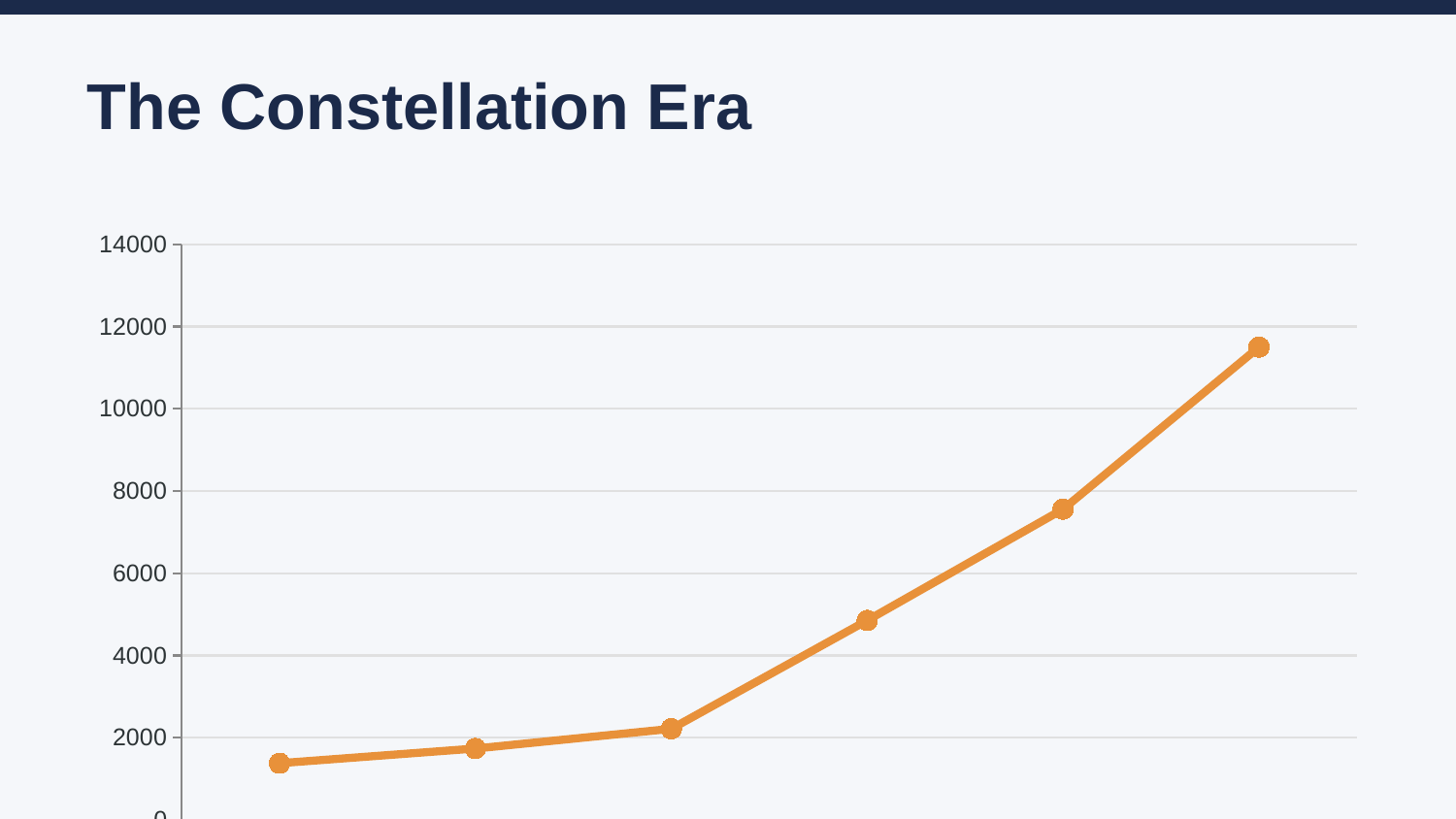
Is the value of the last (rightmost) data point greater or less than 12000? less Which data point has the lowest value, the first or the last? the first Which is larger, the value of the fourth data point or the value of the fifth data point? the fifth data point Is the value of the fourth data point greater or less than 4000? greater Do the values rise or fall from left to right along the x axis? rise What is the title of the slide containing the chart? The Constellation Era Is the value of the last (rightmost) data point greater or less than 10000? greater Which data point has the highest value, the first or the last? the last How many data points are plotted on the line? 6 What kind of chart is shown on the slide? line chart